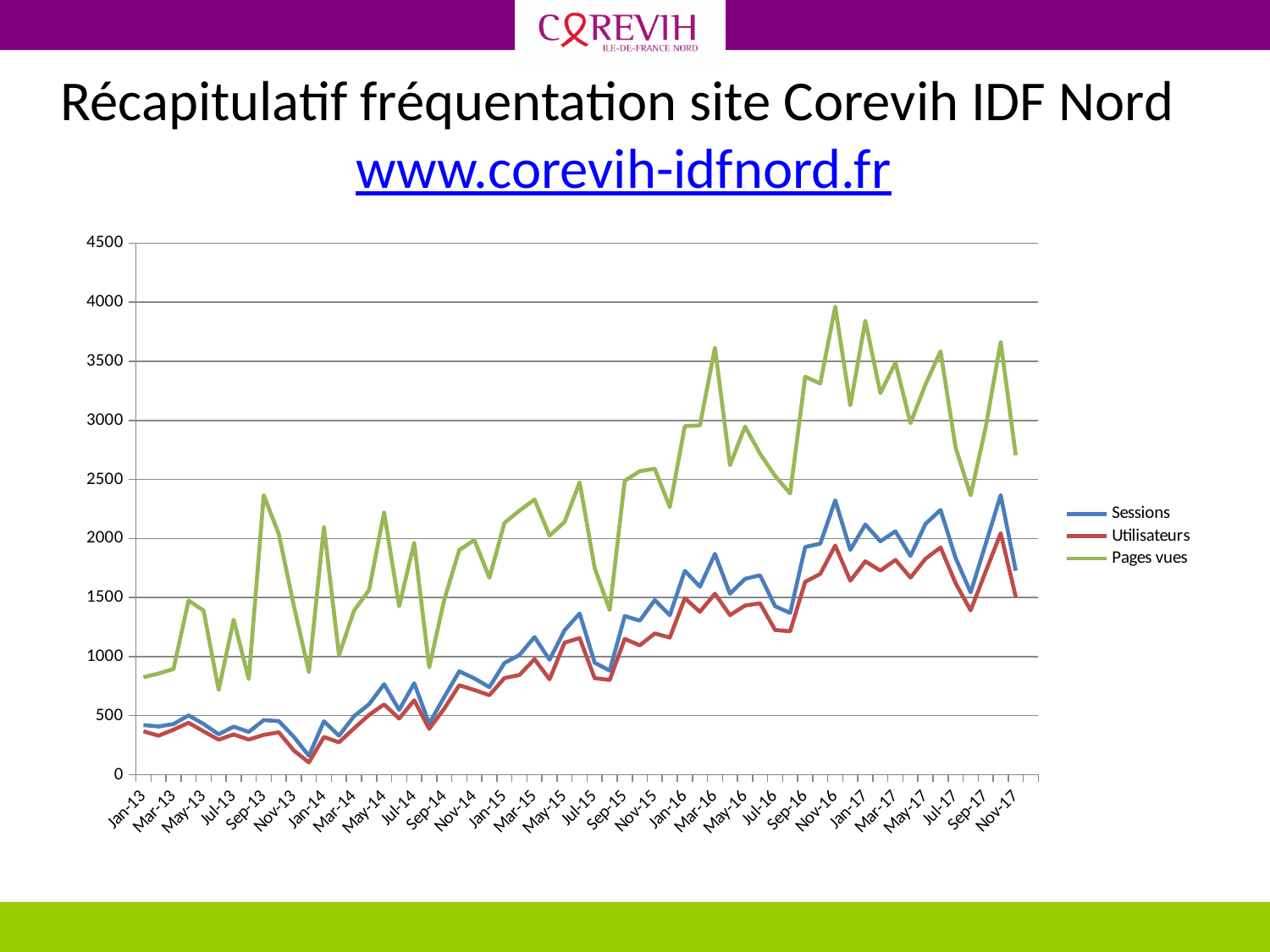
Which is larger in Nov-16, Sessions or Utilisateurs? Sessions What are the three series named in the legend? Sessions, Utilisateurs, Pages vues Is the value of Sessions for Nov-16 greater or less than 2000? greater Do the Sessions values generally rise or fall from Jan-13 to Nov-17? rise What kind of chart is shown on the slide? Line chart Which series has the highest values across the whole period? Pages vues Is the value of Sessions for Jan-13 greater or less than 500? less Is the value of Pages vues for Nov-16 greater or less than 3500? greater How many series does the legend list? 3 Which series is drawn in green? Pages vues Which series has the lowest values across the whole period? Utilisateurs